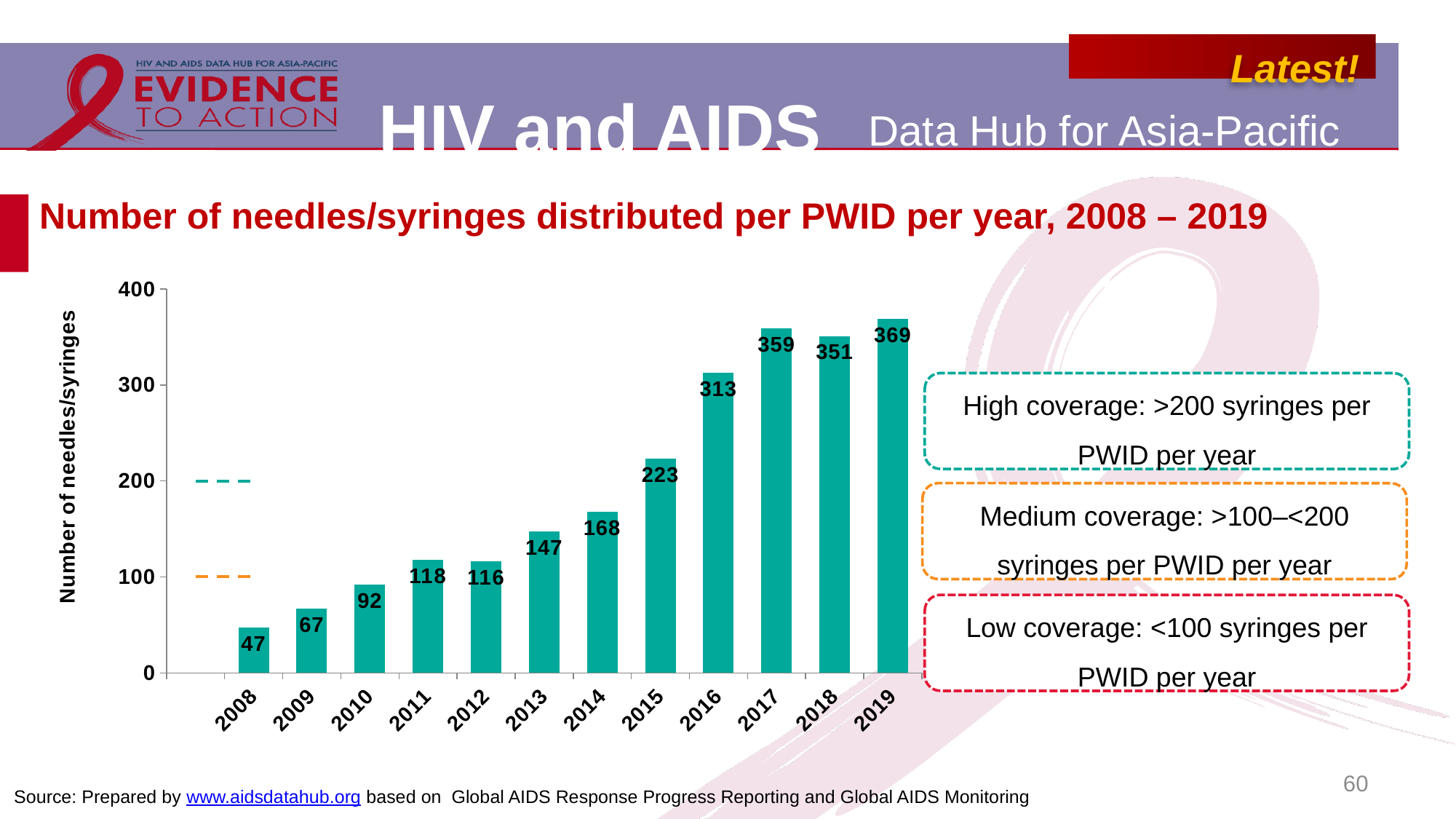
How many years are shown on the x axis of the chart? 12 Which year has the lowest number of needles/syringes distributed per PWID? 2008 Is the value for 2015 greater or less than 200? greater What is the difference between the values for 2019 and 2008? 322 What is the number of needles/syringes distributed per PWID in 2019? 369 What is the difference between the values for 2017 and 2018? 8 What kind of chart is shown on the slide? Bar chart Which year has a larger value, 2011 or 2012? 2011 What is the label of the y axis of the chart? Number of needles/syringes What is the number of needles/syringes distributed per PWID in 2008? 47 What is the number of needles/syringes distributed per PWID in 2016? 313 Which year has the highest number of needles/syringes distributed per PWID? 2019